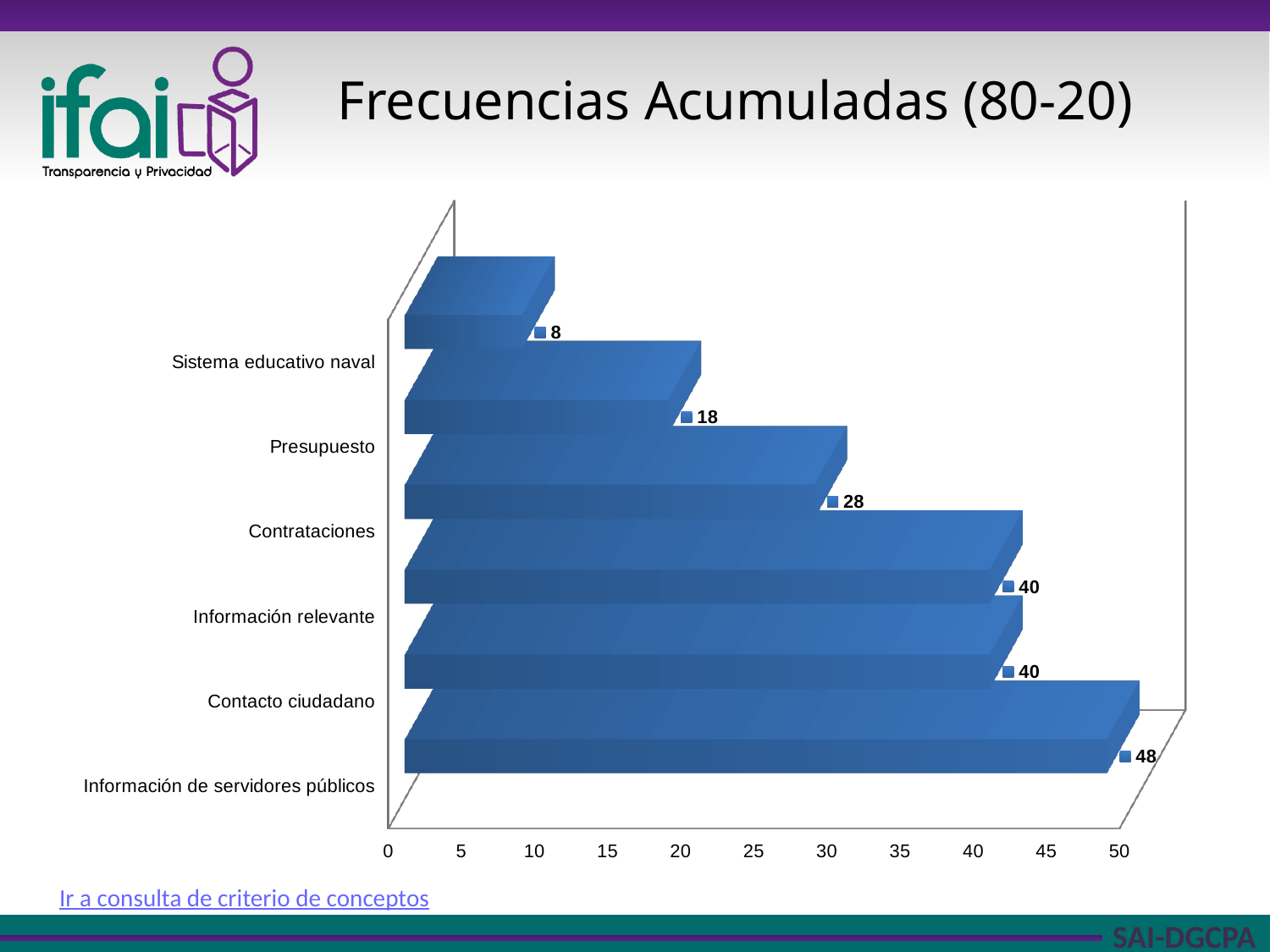
How many categories are shown in the chart? 6 Is the value for Contacto ciudadano greater or less than 35? greater What is the value for Información de servidores públicos? 48 What is the value for Presupuesto? 18 What is the difference between the values for Información de servidores públicos and Contrataciones? 20 Which category has the highest value? Información de servidores públicos Which category has the lowest value? Sistema educativo naval What is the value for Contrataciones? 28 What kind of chart is shown on the slide? Bar chart What is the value for Sistema educativo naval? 8 Which is larger, the value for Presupuesto or the value for Contrataciones? Contrataciones What is the title of the slide containing the chart? Frecuencias Acumuladas (80-20)